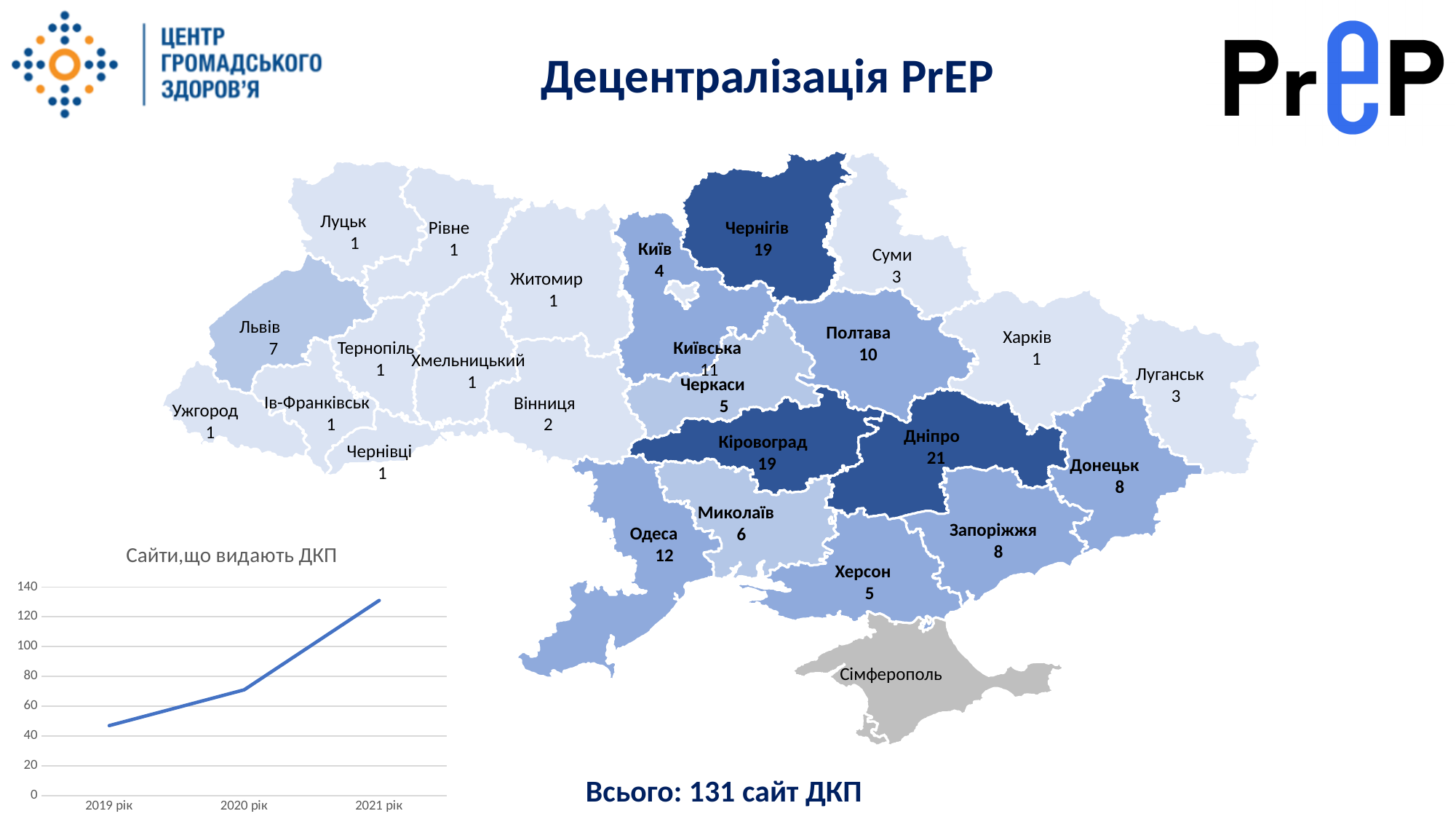
In the line chart 'Сайти,що видають ДКП', which year has the highest value? 2021 рік How many data points are plotted in the line chart 'Сайти,що видають ДКП'? 3 In the line chart 'Сайти,що видають ДКП', is the value for 2021 рік greater or less than 120? greater What kind of chart is the chart titled 'Сайти,що видають ДКП' in the lower left? line chart In the line chart 'Сайти,що видають ДКП', is the value for 2020 рік greater or less than 60? greater On the map of Ukraine, how many sites are shown for Одеса? 12 In the line chart 'Сайти,що видають ДКП', is the value for 2019 рік greater or less than 60? less What is the title of the line chart in the lower left of the slide? Сайти,що видають ДКП On the map of Ukraine, what is the difference between the values for Дніпро and Донецьк? 13 On the map of Ukraine, which region has the highest number of PrEP sites? Дніпро In the line chart 'Сайти,що видають ДКП', which year has the lowest value? 2019 рік In the line chart 'Сайти,що видають ДКП', do the values rise or fall from 2019 рік to 2021 рік? rise